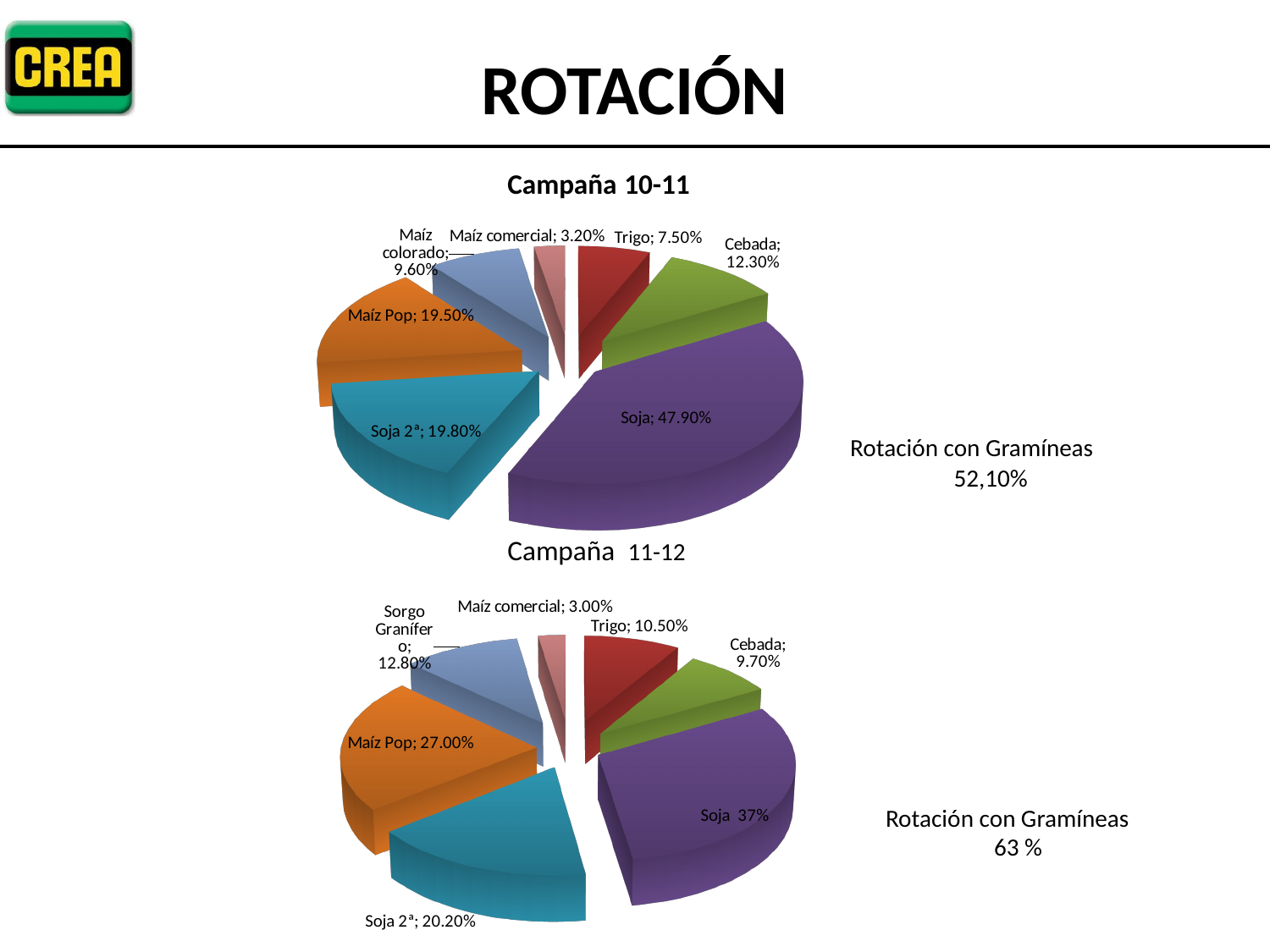
In the Campaña 10-11 chart, which category has the smallest slice? Maíz comercial In the Campaña 10-11 chart, what is the value for Maíz Pop? 19.50% In the Campaña 11-12 chart, what is the difference between Soja and Soja 2ª? 16.80% In the Campaña 11-12 chart, what is the value for Maíz Pop? 27.00% In the Campaña 10-11 chart, how many slices does the pie have? 7 In the Campaña 10-11 chart, what is the difference between Cebada and Trigo? 4.80% In the Campaña 11-12 chart, what share does Sorgo Granífero have? 12.80% What is the Rotación con Gramíneas percentage shown next to the Campaña 11-12 chart? 63 % What type of chart is used for Campaña 11-12? Pie chart In the Campaña 10-11 chart, what share does Soja have? 47.90% In the Campaña 10-11 chart, which category has the largest slice? Soja In the Campaña 11-12 chart, which is larger, Trigo or Cebada? Trigo